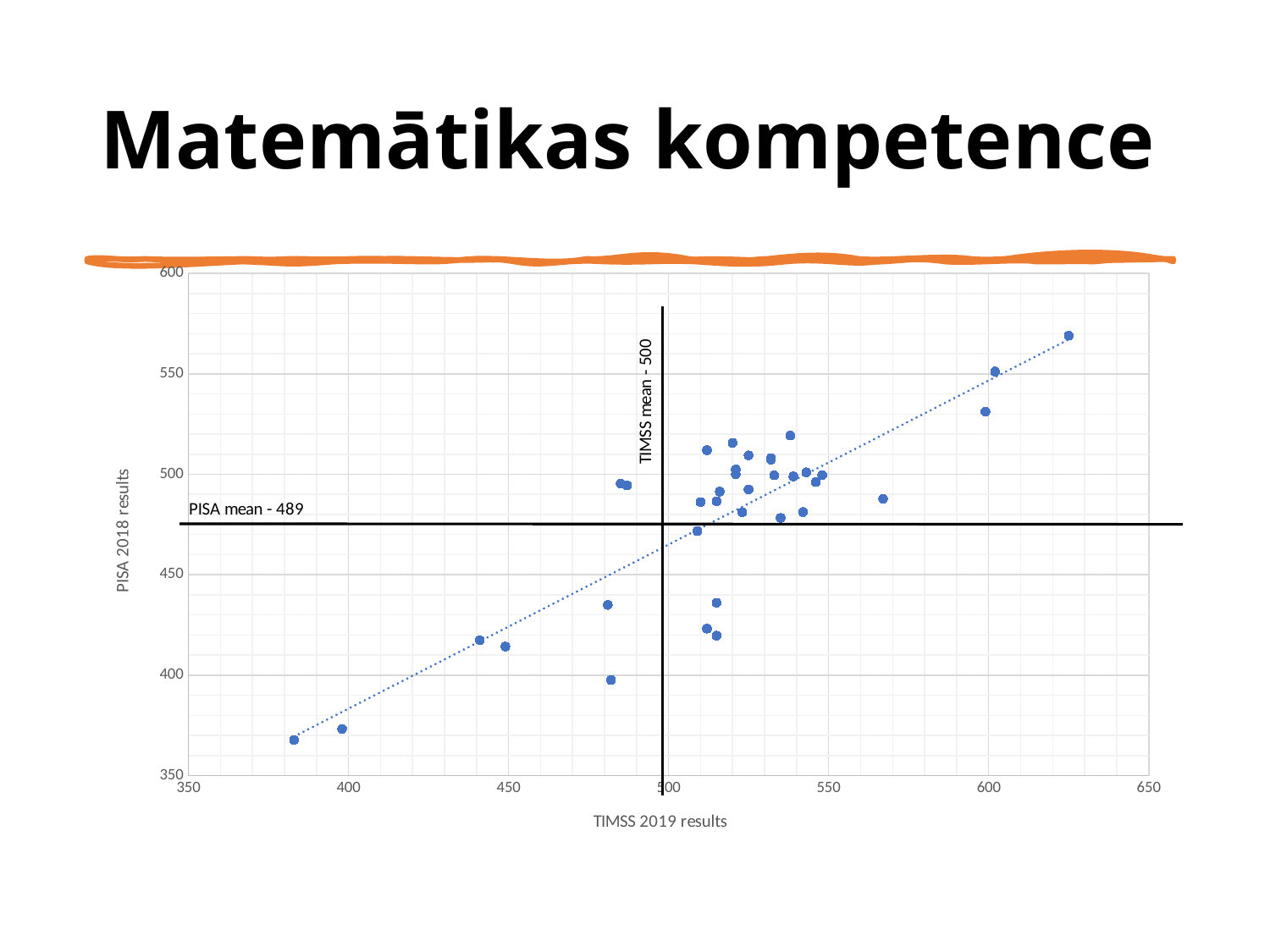
Is the TIMSS 2019 value of the leftmost point on the chart greater or less than 400? less Is the PISA 2018 value of the lowest point on the chart greater or less than 400? less Do the PISA 2018 results generally rise or fall as TIMSS 2019 results increase along the x axis? rise What PISA mean value is marked by the horizontal reference line on the chart? 489 Is the TIMSS 2019 value of the highest point on the chart greater or less than 600? greater What is the label of the horizontal (x) axis of the chart? TIMSS 2019 results What is the label of the vertical (y) axis of the chart? PISA 2018 results What kind of chart is shown on the slide? scatter chart What is the maximum value shown on the vertical axis of the chart? 600 What TIMSS mean value is marked by the vertical reference line on the chart? 500 Which point has the higher PISA 2018 result: the rightmost point or the leftmost point? the rightmost point